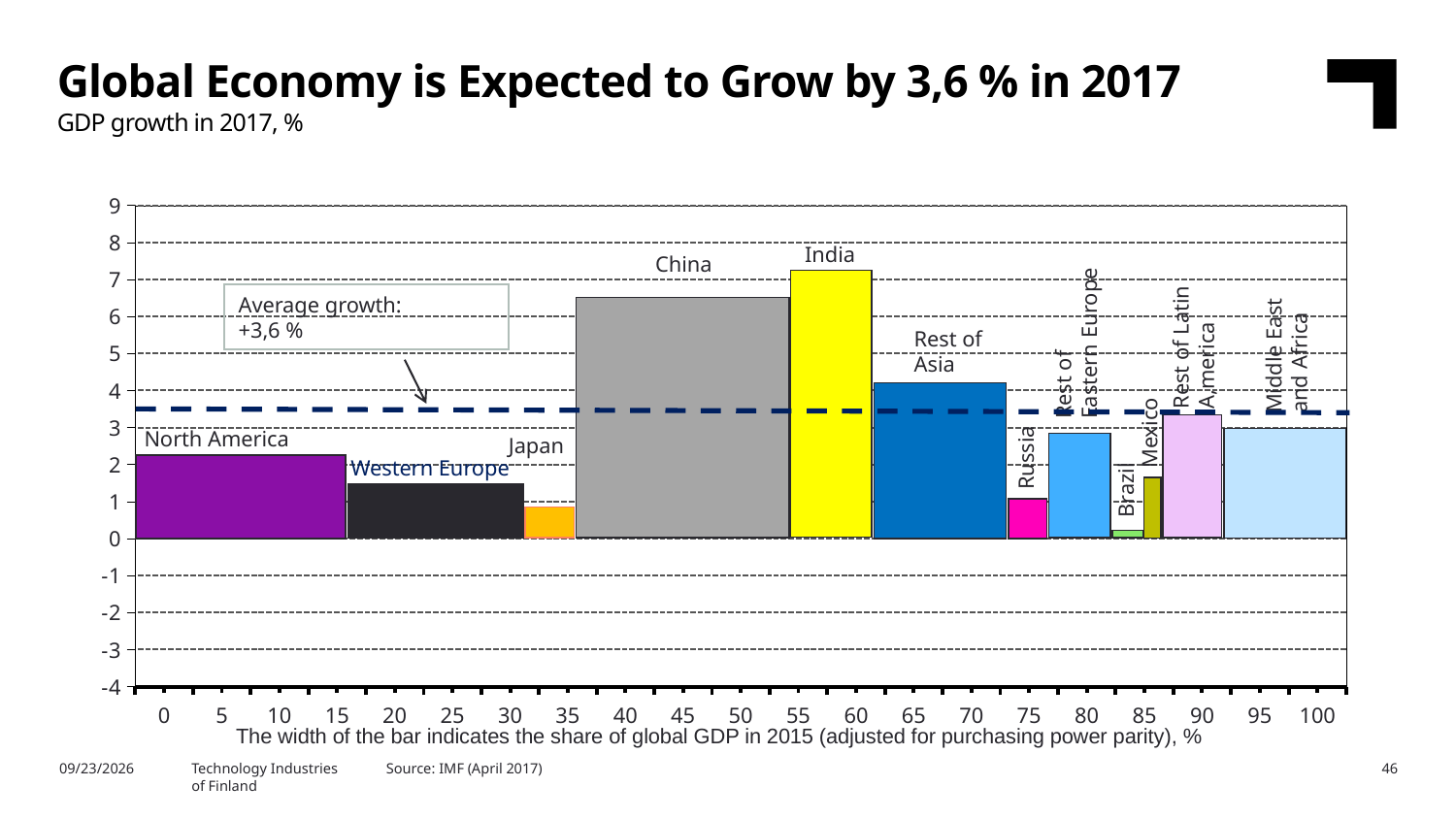
Is the GDP growth value for North America greater or less than 3? less Which region has the lowest GDP growth in 2017 on the chart? Brazil Which has higher GDP growth in 2017, North America or Western Europe? North America Which has higher GDP growth in 2017, China or Rest of Asia? China How many regions are shown as bars on the chart? 12 Is the GDP growth value for China greater or less than 6? greater Is the GDP growth value for Rest of Asia greater or less than 3? greater What is the average global GDP growth shown on the chart? +3,6 % What type of chart is shown on the slide? Bar chart Which region has the highest GDP growth in 2017 on the chart? India What does the width of each bar indicate? The share of global GDP in 2015 (adjusted for purchasing power parity)